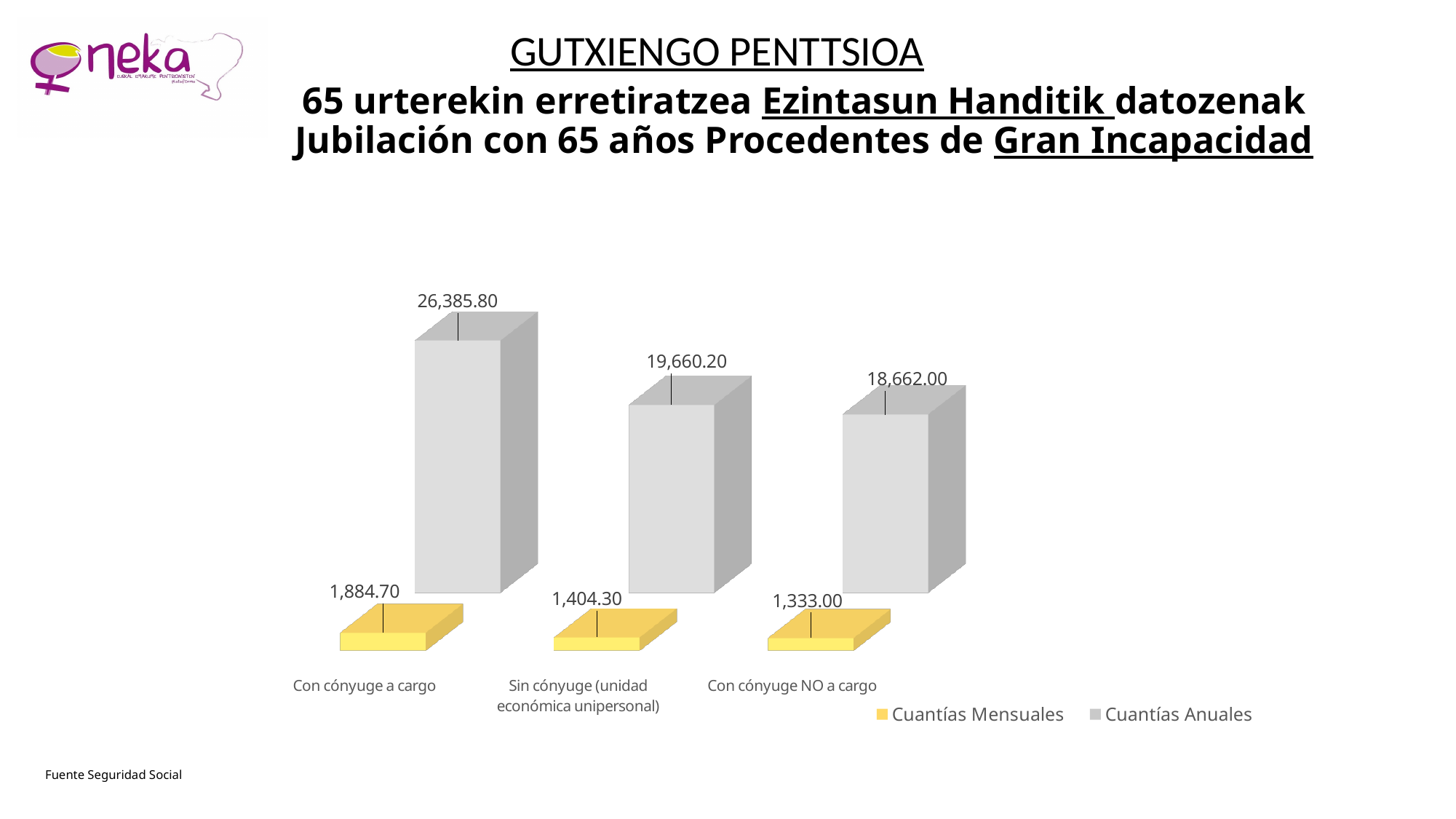
What is the Cuantías Mensuales value for Con cónyuge a cargo? 1,884.70 Which is larger: the Cuantías Anuales value for Sin cónyuge (unidad económica unipersonal) or for Con cónyuge NO a cargo? Sin cónyuge (unidad económica unipersonal) How many categories are shown on the x axis of the chart? 3 How many series does the chart legend list? 2 What is the difference between the Cuantías Mensuales values for Con cónyuge a cargo and Con cónyuge NO a cargo? 551.70 Which category has the highest Cuantías Anuales value? Con cónyuge a cargo Which category has the lowest Cuantías Mensuales value? Con cónyuge NO a cargo What is the difference between the Cuantías Anuales values for Con cónyuge a cargo and Sin cónyuge (unidad económica unipersonal)? 6,725.60 What is the Cuantías Anuales value for Con cónyuge a cargo? 26,385.80 What is the Cuantías Anuales value for Con cónyuge NO a cargo? 18,662.00 What kind of chart is shown on the slide? Bar chart What is the Cuantías Mensuales value for Sin cónyuge (unidad económica unipersonal)? 1,404.30